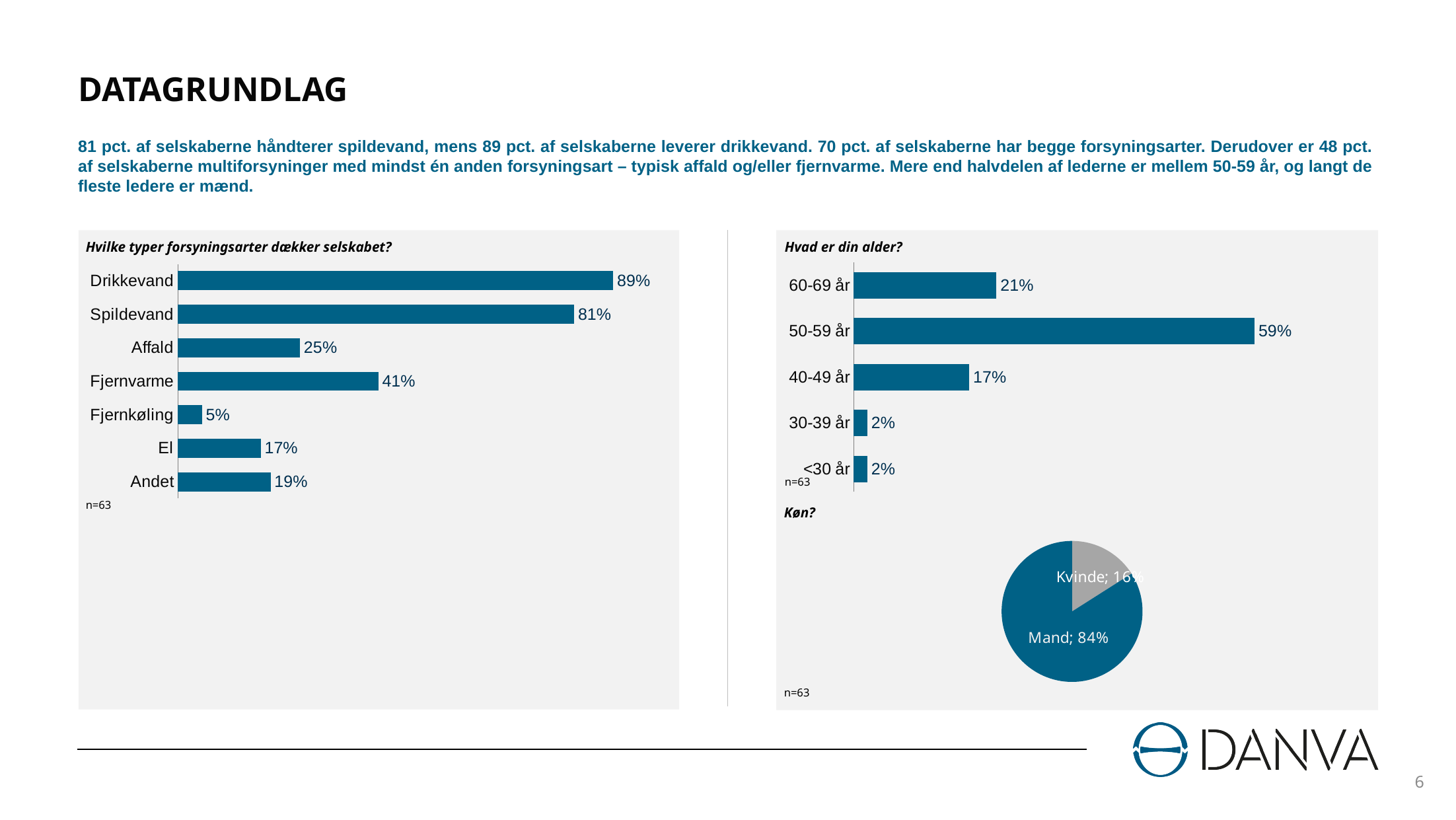
In the chart 'Hvilke typer forsyningsarter dækker selskabet?', how many categories are shown? 7 In the chart 'Hvilke typer forsyningsarter dækker selskabet?', which is larger, the value for Affald or the value for Andet? Affald In the chart 'Hvad er din alder?', which age group has the highest value? 50-59 år In the chart 'Hvilke typer forsyningsarter dækker selskabet?', which category has the lowest value? Fjernkøling In the chart 'Hvilke typer forsyningsarter dækker selskabet?', what is the difference between the values for Drikkevand and Spildevand? 8% In the chart 'Køn?', what share of the pie is Mand? 84% In the chart 'Hvad er din alder?', what is the value for 60-69 år? 21% In the chart 'Hvad er din alder?', what is the difference between the values for 50-59 år and 40-49 år? 42% In the chart 'Hvilke typer forsyningsarter dækker selskabet?', what is the value for Fjernvarme? 41% In the chart 'Hvilke typer forsyningsarter dækker selskabet?', which category has the highest value? Drikkevand In the chart 'Hvad er din alder?', how many age groups are shown? 5 What kind of chart is the chart titled 'Køn?'? Pie chart